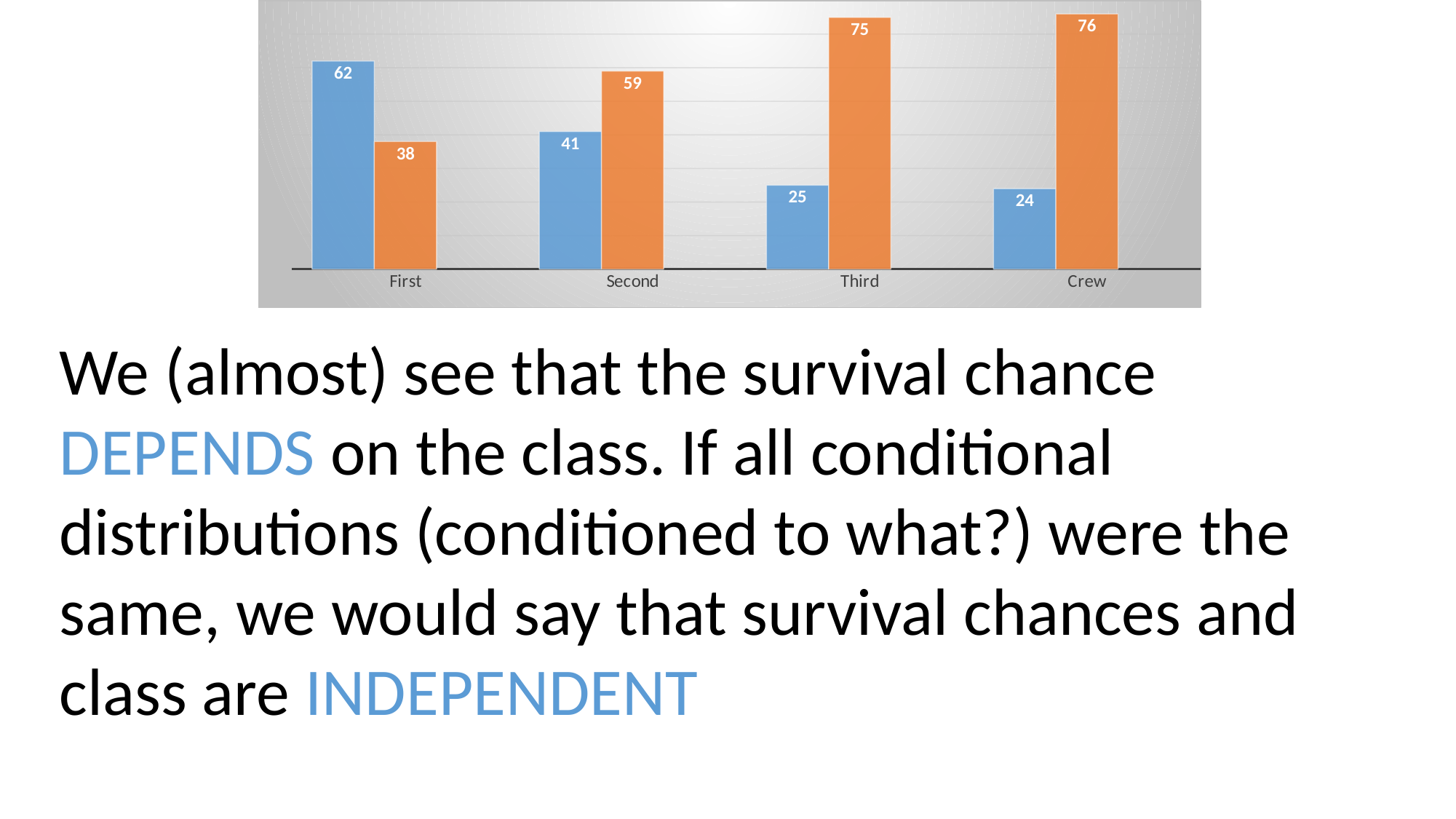
What is the value of the orange bar for Second? 59 Do the orange bar values rise or fall from First to Crew? rise What kind of chart is shown on the slide? bar chart Which category has the lowest orange bar? First What is the value of the orange bar for Third? 75 What is the value of the blue bar for First? 62 What is the difference between the blue bars for First and Second? 21 How many categories are shown on the x axis? 4 What is the value of the blue bar for Crew? 24 What is the difference between the orange and blue bars for Third? 50 For Second, which bar is larger, the blue or the orange? orange Which category has the highest blue bar? First